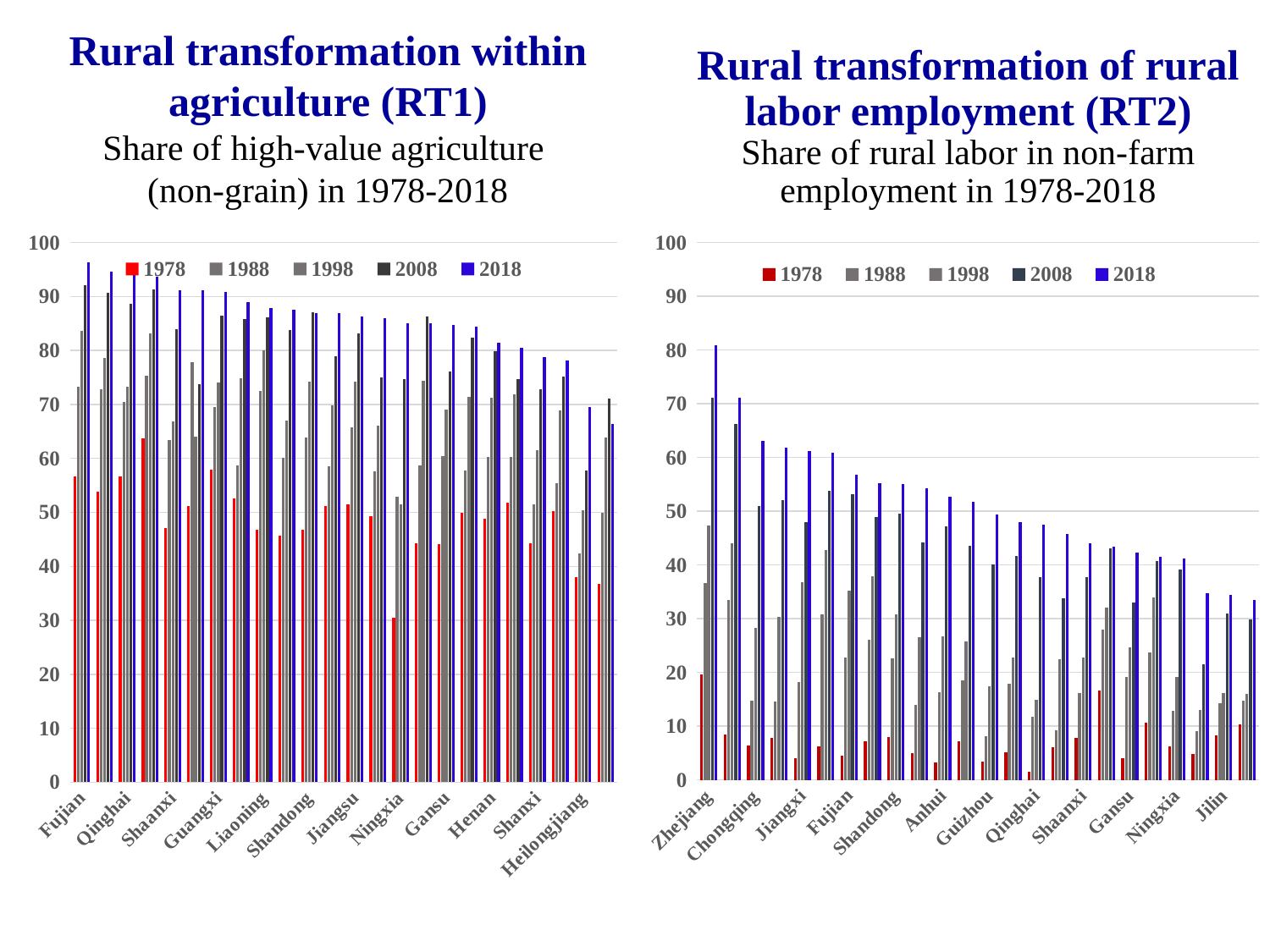
In the right chart (RT2), do the 2018 values generally rise or fall from left to right along the x axis? Fall In the right chart (RT2), what colour represents the 2018 series? Blue What kind of chart is the left chart, 'Rural transformation within agriculture (RT1)'? Bar chart In the right chart (RT2), is the 2018 value for Zhejiang greater or less than 70? greater How many series does the legend of the right chart, 'Rural transformation of rural labor employment (RT2)', list? 5 In the right chart (RT2), is the 2018 value for Jilin greater or less than 40? less In the left chart (RT1), which is larger: the 2018 value for Fujian or the 2018 value for Heilongjiang? Fujian In the right chart (RT2), which category has the highest 2018 value? Zhejiang In the left chart (RT1), is the 2018 value for Fujian greater or less than 90? greater In the right chart (RT2), which is larger: the 2018 value for Zhejiang or the 2018 value for Jilin? Zhejiang